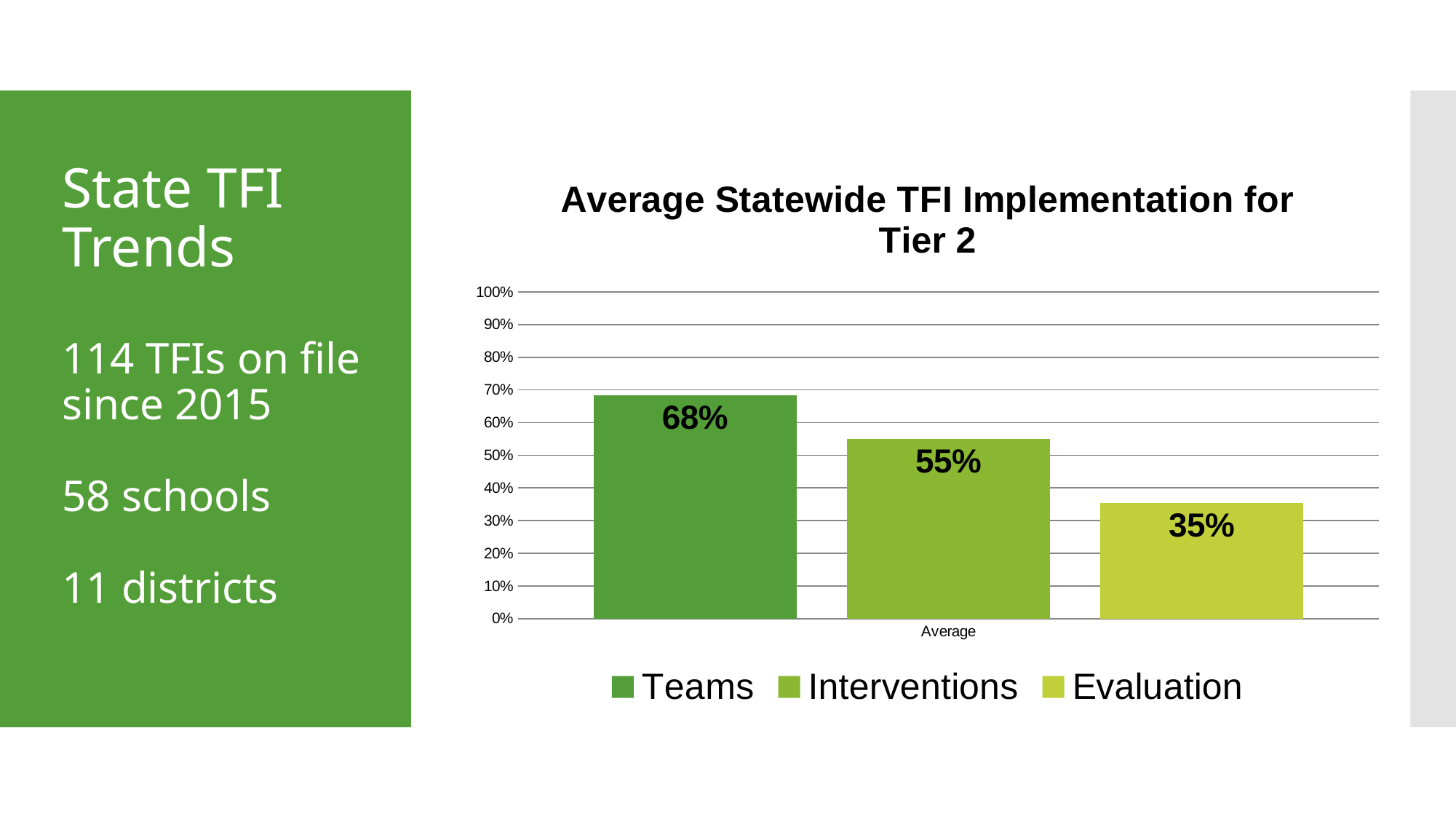
Is the value for Interventions greater or less than 50%? greater Which series has the lowest value? Evaluation What is the title of the chart? Average Statewide TFI Implementation for Tier 2 What is the difference between the Teams value and the Interventions value? 13% What is the difference between the Teams value and the Evaluation value? 33% What is the value for Teams? 68% What is the value for Interventions? 55% What kind of chart is shown on the slide? bar chart Which series has the highest value? Teams Which is larger, the value for Interventions or the value for Evaluation? Interventions What is the value for Evaluation? 35% How many series does the legend list? 3